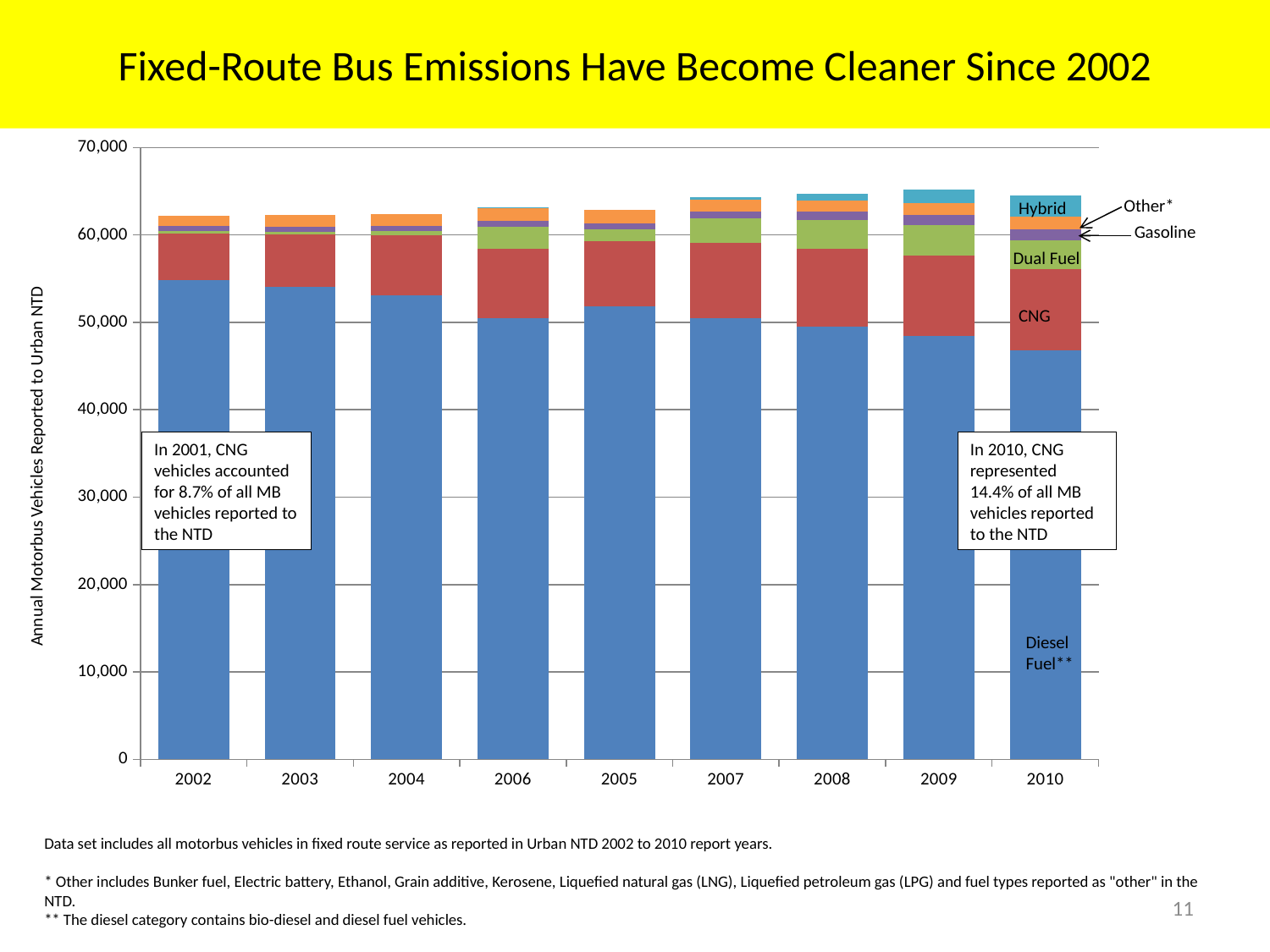
How many years (bars) are shown along the x axis of the chart? 9 What is the title of the chart on the slide? Fixed-Route Bus Emissions Have Become Cleaner Since 2002 How many fuel categories are labeled on the chart? 6 Which year has the smallest Diesel Fuel segment? 2010 Is the Diesel Fuel value for 2010 greater or less than 50,000? less What kind of chart is shown on the slide? stacked bar chart Is the total height of the 2002 bar greater or less than 60,000? greater Is the Diesel Fuel value for 2002 greater or less than 50,000? greater Which year has the largest Diesel Fuel segment? 2002 Which fuel category forms the bottom (largest) segment of each bar? Diesel Fuel** Which year has the larger Diesel Fuel segment, 2002 or 2010? 2002 Does the Diesel Fuel segment rise or fall from 2002 to 2010 along the x axis? fall